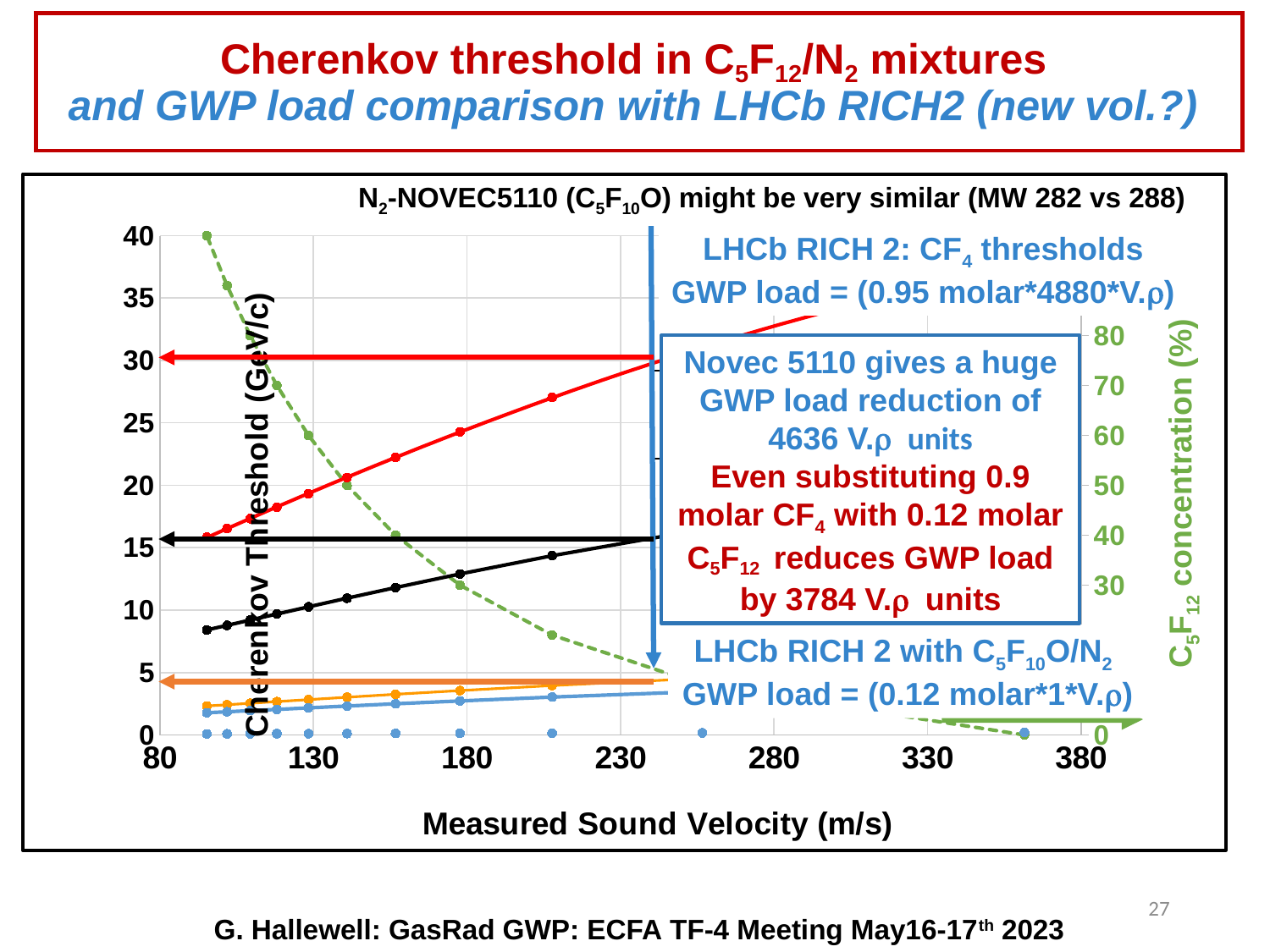
Is the Cherenkov threshold on the black line at 100 m/s greater or less than 10 GeV/c? less Does the black line rise or fall as measured sound velocity increases? rises What kind of chart is shown on the slide? line chart Is the Cherenkov threshold on the black line at 230 m/s greater or less than 20 GeV/c? less Does the red line rise or fall as measured sound velocity increases? rises Is the Cherenkov threshold on the red line at 180 m/s greater or less than 20 GeV/c? greater Does the green dashed line rise or fall as measured sound velocity increases? falls What is the title of the x axis of the chart? Measured Sound Velocity (m/s) At 180 m/s, which line shows the higher Cherenkov threshold, the red line or the black line? red line What is the title of the left y axis of the chart? Cherenkov Threshold (GeV/c)